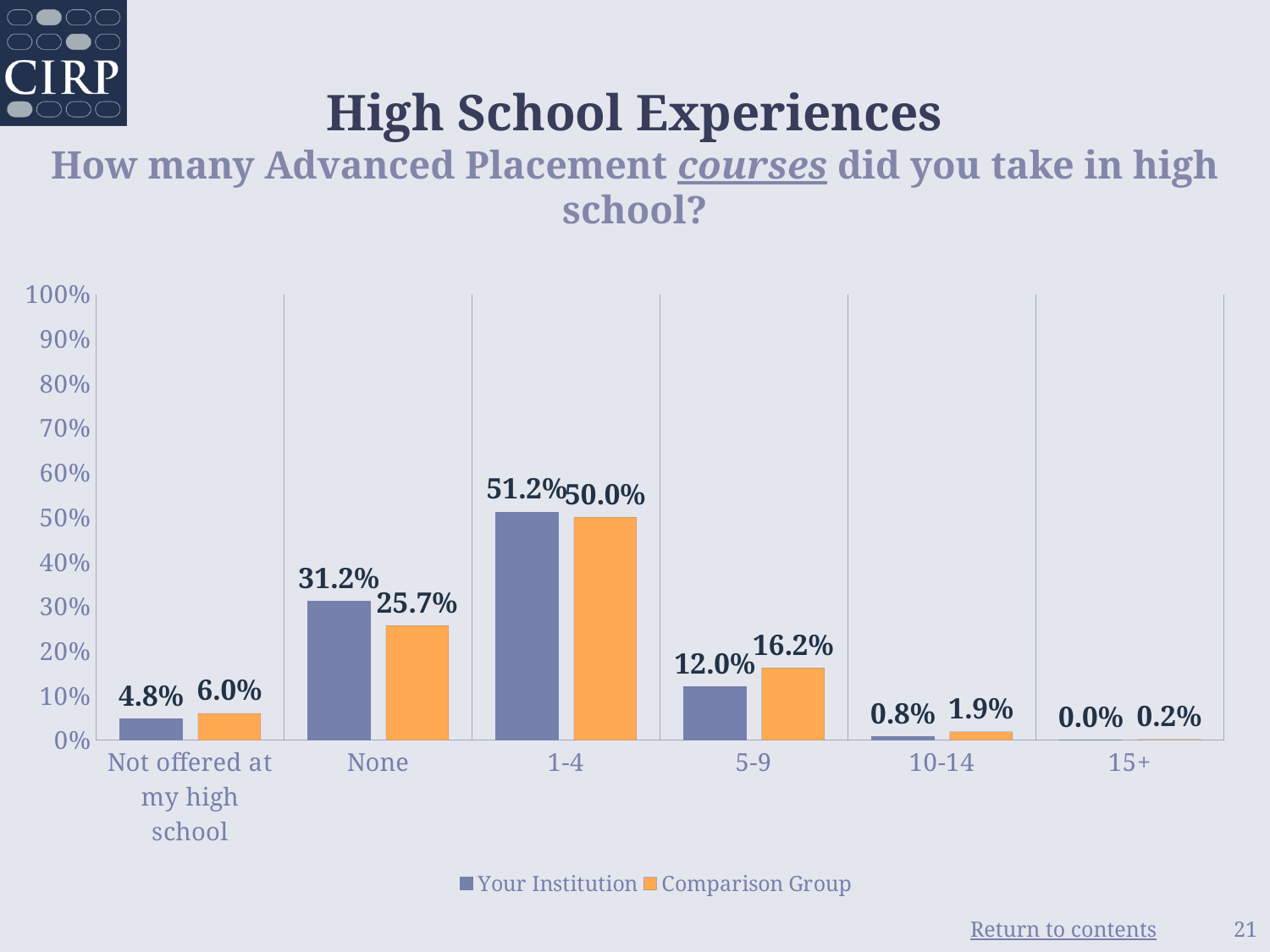
Which is larger in the Not offered at my high school category, Your Institution or Comparison Group? Comparison Group What is the value for Your Institution in the 1-4 category? 51.2% Is the value for Your Institution in the 1-4 category greater or less than 40%? greater What is the difference between Your Institution and Comparison Group in the None category? 5.5% Which category has the highest value for Comparison Group? 1-4 What is the difference between Comparison Group and Your Institution in the 5-9 category? 4.2% What is the value for Comparison Group in the None category? 25.7% How many categories are shown on the x axis? 6 How many series does the legend list? 2 What is the value for Your Institution in the 10-14 category? 0.8% Which category has the lowest value for Your Institution? 15+ What kind of chart is shown on the slide? bar chart